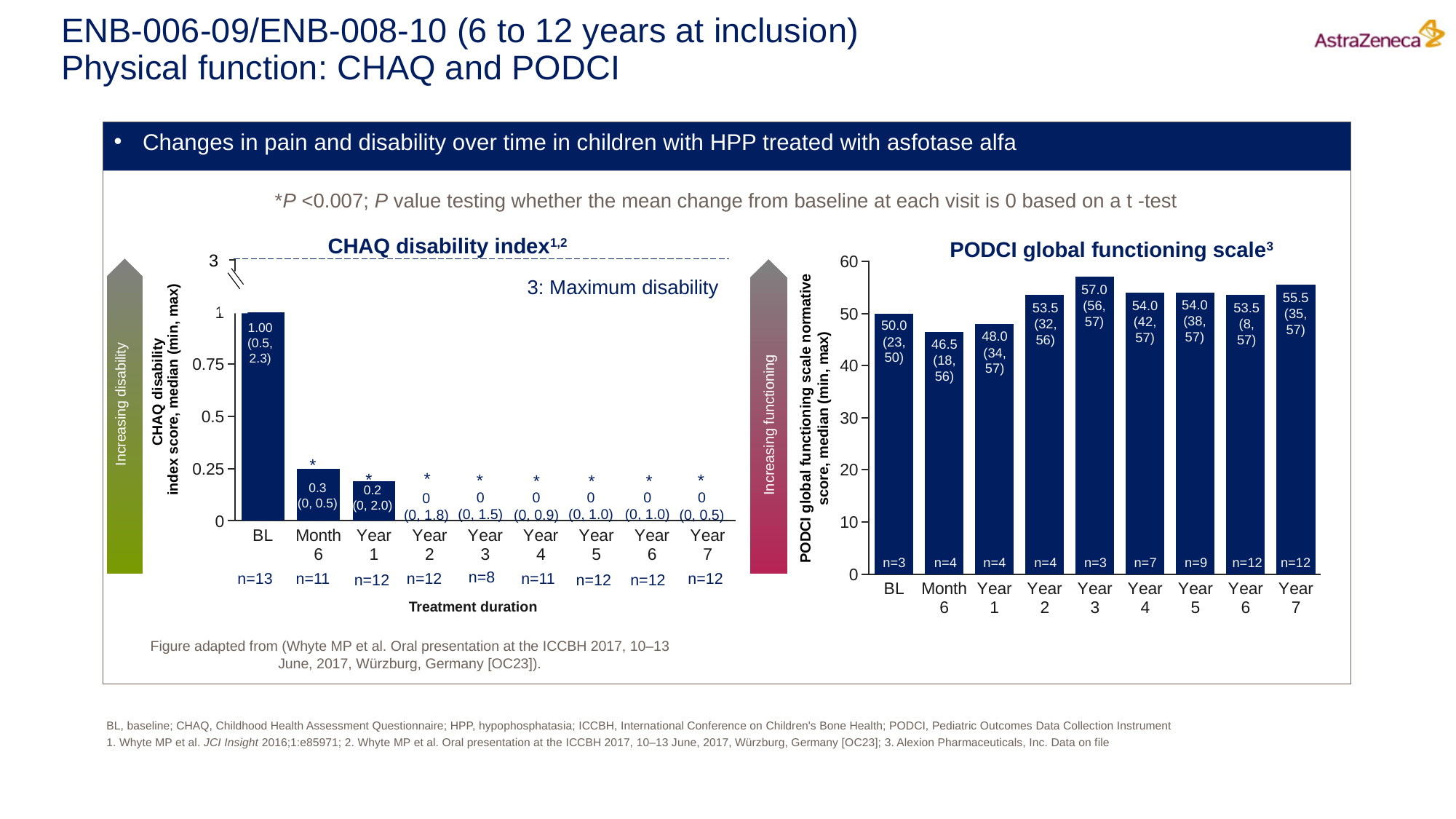
What type of chart is the CHAQ disability index chart? Bar chart How many time points are plotted in the PODCI global functioning scale chart? 9 In the CHAQ disability index chart, what is the median score at Month 6? 0.3 In the PODCI global functioning scale chart, what is the median score at Year 3? 57.0 In the CHAQ disability index chart, what is the median score at baseline (BL)? 1.00 In the CHAQ disability index chart, what is the difference between the median score at BL and at Year 1? 0.8 In the CHAQ disability index chart, which time point has the highest median score? BL In the PODCI global functioning scale chart, is the median score at Year 1 larger or smaller than at Year 2? smaller In the CHAQ disability index chart, how many patients (n) are included at Year 3? n=8 In the PODCI global functioning scale chart, which time point has the highest median score? Year 3 In the PODCI global functioning scale chart, what is the difference between the median score at Year 7 and at BL? 5.5 In the PODCI global functioning scale chart, which time point has the lowest median score? Month 6